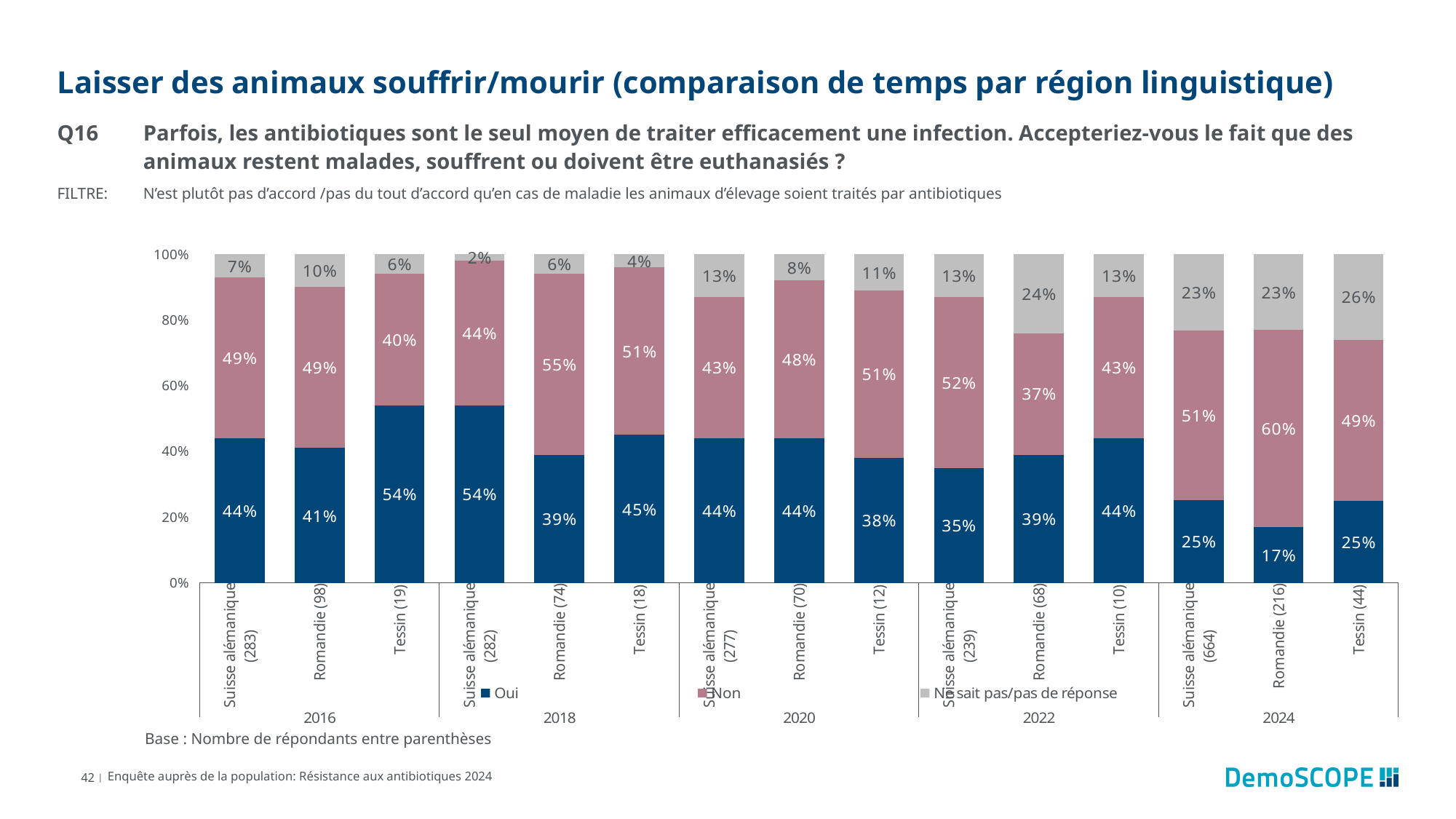
What percentage of respondents in Romandie (216) in 2024 answered "Non"? 60% How many bars are shown in the chart? 15 What is the difference between the "Oui" value for Suisse alémanique in 2018 and in 2024? 29 percentage points What type of chart is shown on the slide? Stacked bar chart How many series does the legend list? 3 Which bar has the lowest "Oui" value? Romandie (216), 2024 Which bar has the highest "Ne sait pas/pas de réponse" value? Tessin (44), 2024 Which bar has the highest "Non" value? Romandie (216), 2024 What is the "Ne sait pas/pas de réponse" value for Suisse alémanique (282) in 2018? 2% What is the "Oui" value for Tessin (19) in 2016? 54% Is the "Non" value larger for Romandie (74) in 2018 or for Romandie (68) in 2022? Romandie (74) in 2018 How does the "Oui" value for Suisse alémanique change from 2018 to 2024? It falls